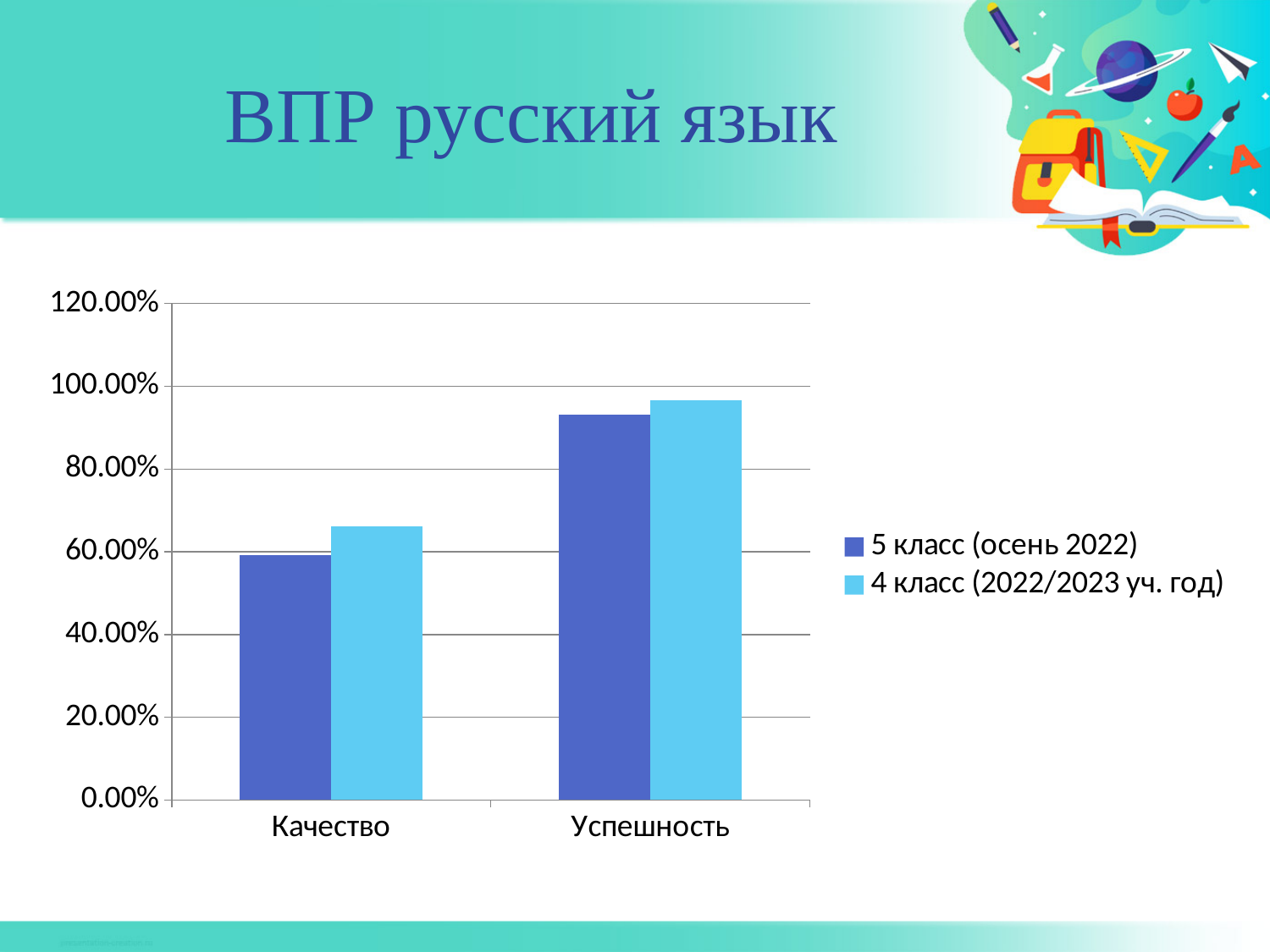
For 5 класс (осень 2022), which category has the higher value: Качество or Успешность? Успешность How many series does the legend list? 2 How many categories are shown on the x axis? 2 Is the value for Успешность in 4 класс (2022/2023 уч. год) greater or less than 100.00%? less Is the value for Качество in 5 класс (осень 2022) greater or less than 40.00%? greater For Качество, which series has the larger value: 5 класс (осень 2022) or 4 класс (2022/2023 уч. год)? 4 класс (2022/2023 уч. год) What is the title of the slide containing the chart? ВПР русский язык Is the value for Качество in 4 класс (2022/2023 уч. год) greater or less than 60.00%? greater Which legend entry is shown in the lighter blue colour? 4 класс (2022/2023 уч. год) What kind of chart is shown on the slide? bar chart Which category has the lowest bar for 5 класс (осень 2022)? Качество